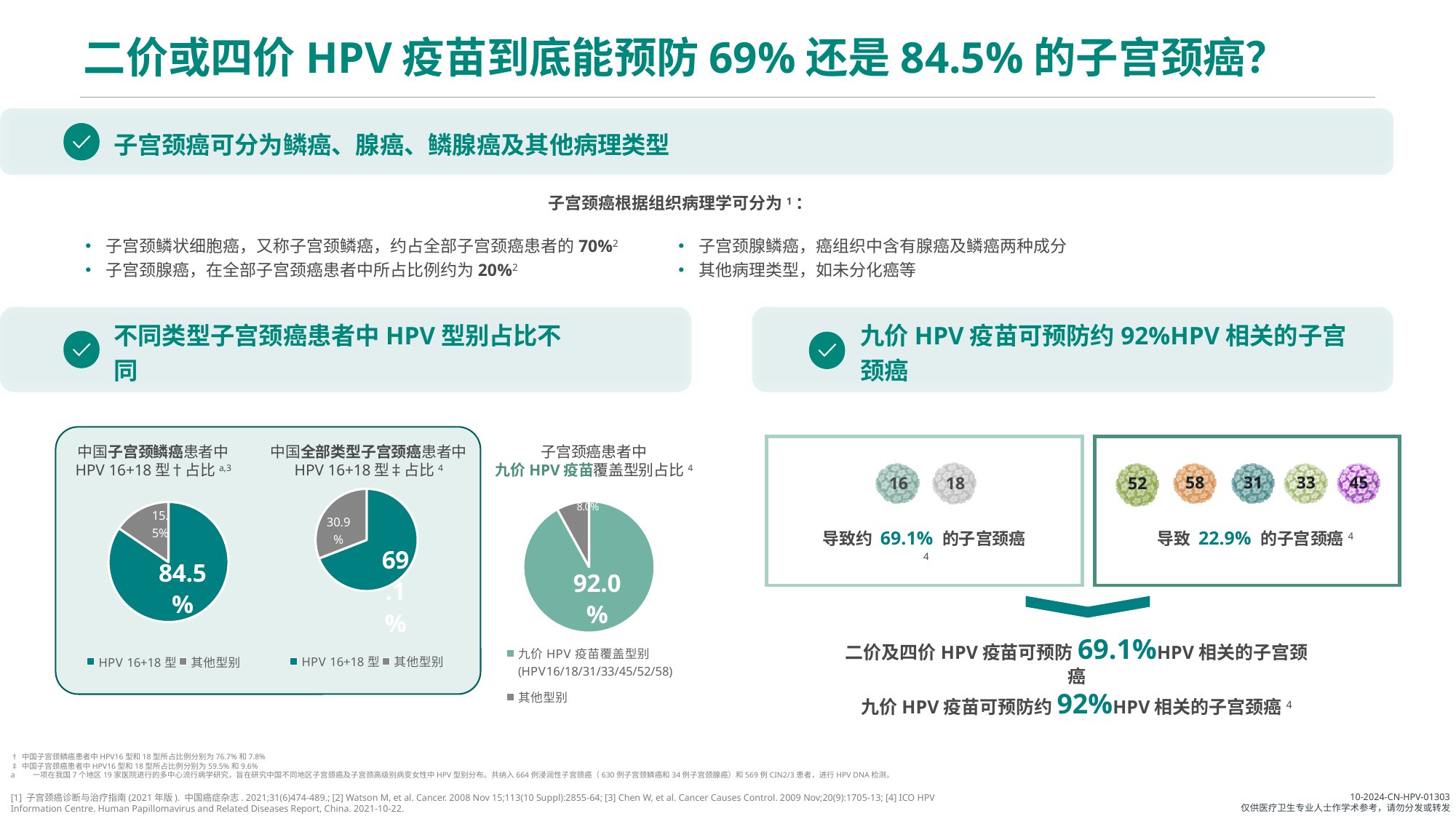
In the '子宫颈癌患者中九价 HPV 疫苗覆盖型别占比' pie chart, what share is covered by 九价 HPV 疫苗覆盖型别? 92.0% In the '子宫颈癌患者中九价 HPV 疫苗覆盖型别占比' pie chart, what is the value for 其他型别? 8.0% Which is larger: the HPV 16+18 型 share in the '中国子宫颈鳞癌患者中' pie chart or in the '中国全部类型子宫颈癌患者中' pie chart? 中国子宫颈鳞癌患者中 (84.5%) In the '中国子宫颈鳞癌患者中 HPV 16+18 型占比' pie chart, what is the value for HPV 16+18 型? 84.5% How many slices does the '中国子宫颈鳞癌患者中 HPV 16+18 型占比' pie chart have? 2 In the '子宫颈癌患者中九价 HPV 疫苗覆盖型别占比' pie chart, which slice is the smallest? 其他型别 In the '中国全部类型子宫颈癌患者中 HPV 16+18 型占比' pie chart, what is the value for HPV 16+18 型? 69.1% What type of chart is used for the '中国子宫颈鳞癌患者中 HPV 16+18 型占比' chart? Pie chart In the '中国子宫颈鳞癌患者中 HPV 16+18 型占比' pie chart, what share does 其他型别 take? 15.5% What is the difference between the HPV 16+18 型 share in the '中国子宫颈鳞癌患者中' pie chart (84.5%) and in the '中国全部类型子宫颈癌患者中' pie chart (69.1%)? 15.4 percentage points In the '中国全部类型子宫颈癌患者中 HPV 16+18 型占比' pie chart, what is the value for 其他型别? 30.9% In the '中国全部类型子宫颈癌患者中 HPV 16+18 型占比' pie chart, which slice is the largest? HPV 16+18 型